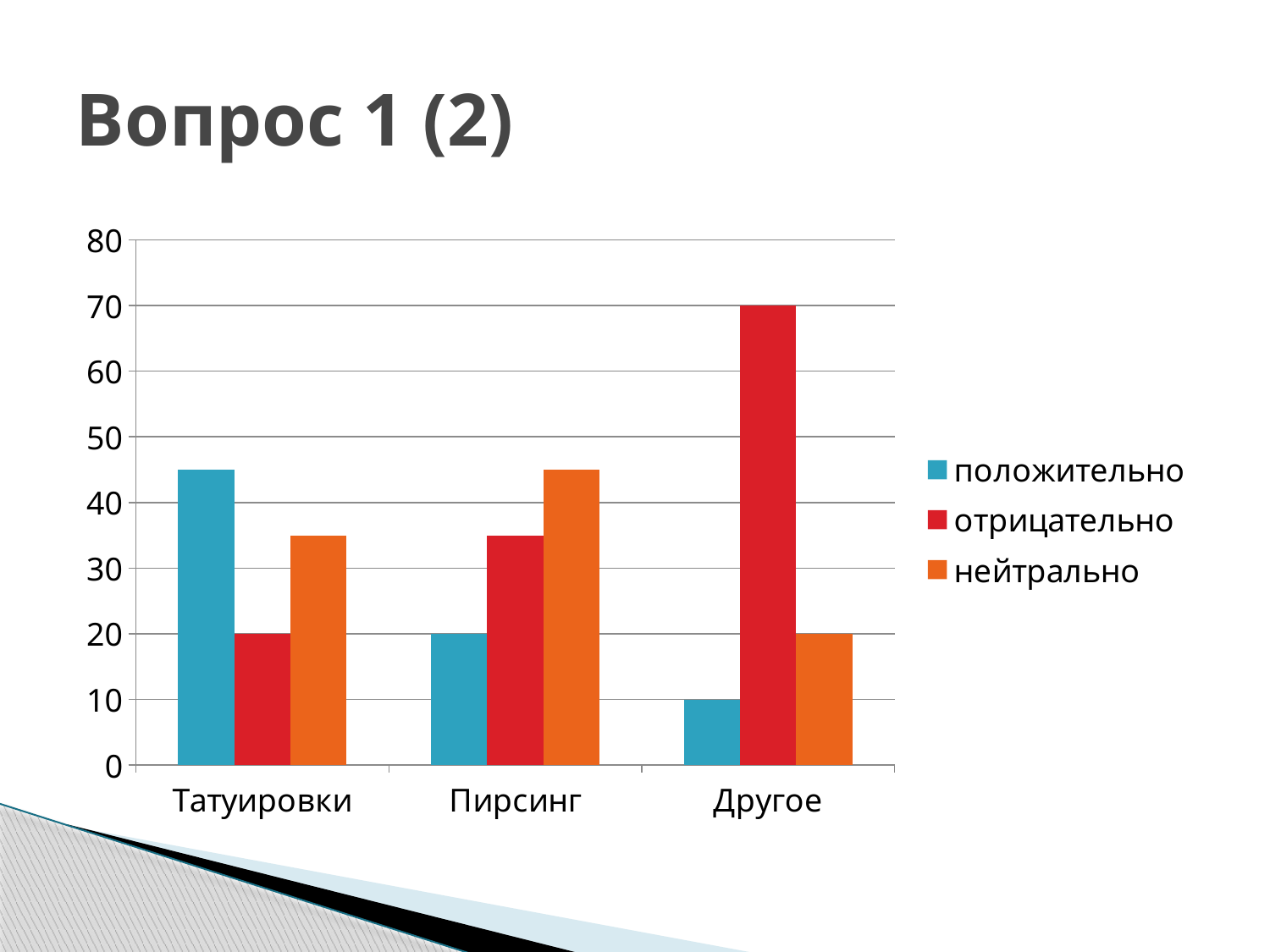
How many categories are shown on the x axis? 3 What is the value for отрицательно in the Другое category? 70 What is the value for положительно in the Пирсинг category? 20 How many series does the legend list? 3 Is the value for нейтрально in the Татуировки category greater or less than 40? less What is the value for отрицательно in the Татуировки category? 20 Is the value for положительно in the Татуировки category greater or less than 40? greater Which category has the lowest положительно value? Другое What kind of chart is shown on the slide? bar chart Which category has the highest отрицательно value? Другое What is the value for положительно in the Другое category? 10 Which is larger in the Пирсинг category: отрицательно or нейтрально? нейтрально